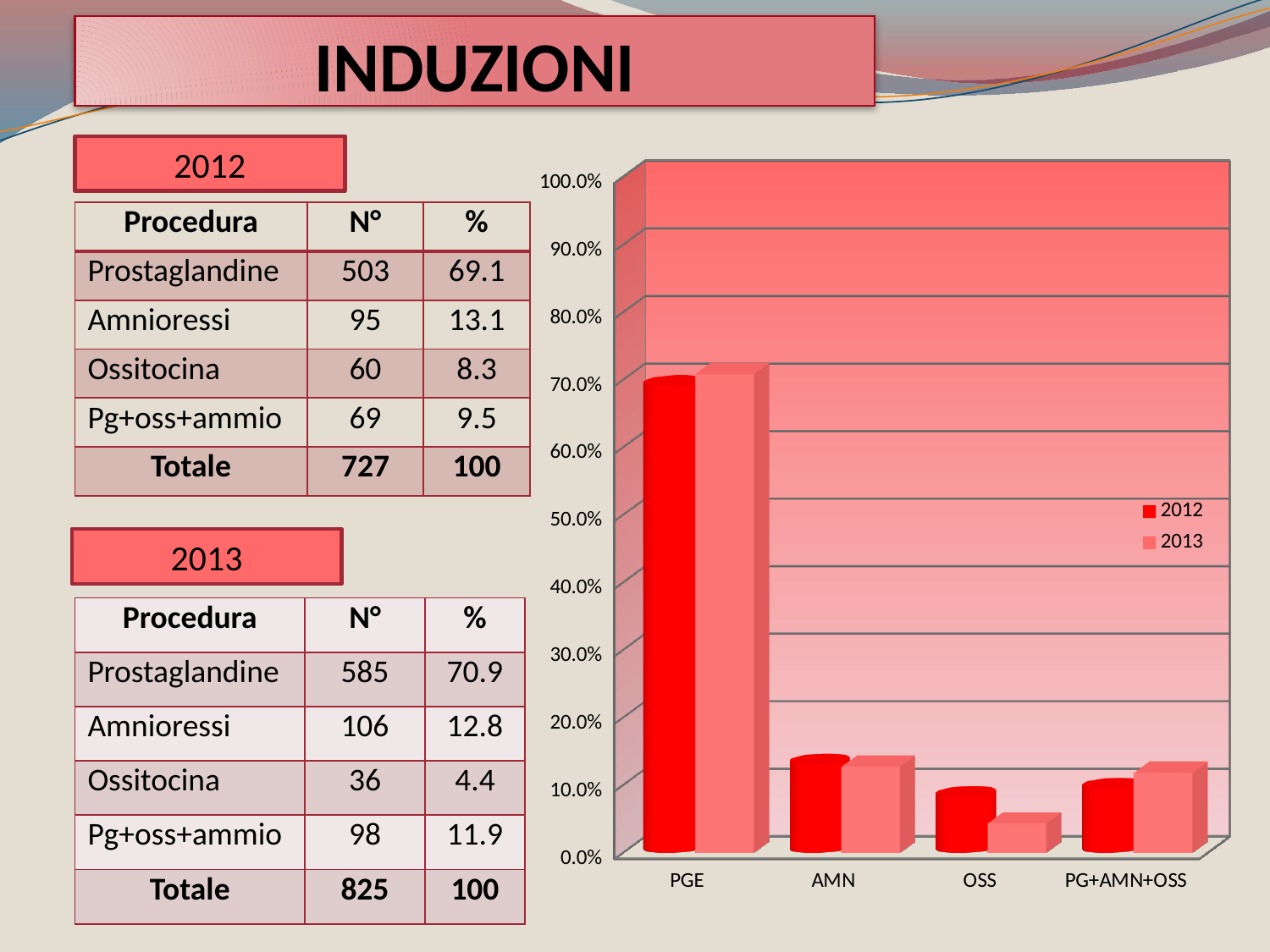
What kind of chart is shown on the slide? bar chart Is the 2013 value for OSS greater or less than 10.0%? less For PG+AMN+OSS, which series has the larger value, 2012 or 2013? 2013 Is the 2013 value for PGE greater or less than 80.0%? less How many categories are shown on the x axis of the chart? 4 Which category has the lowest value for the 2013 series? OSS Which category has the highest value for the 2013 series? PGE Is the 2012 value for PGE greater or less than 60.0%? greater How many series does the chart legend list? 2 For OSS, which series has the larger value, 2012 or 2013? 2012 Which category has the highest value for the 2012 series? PGE